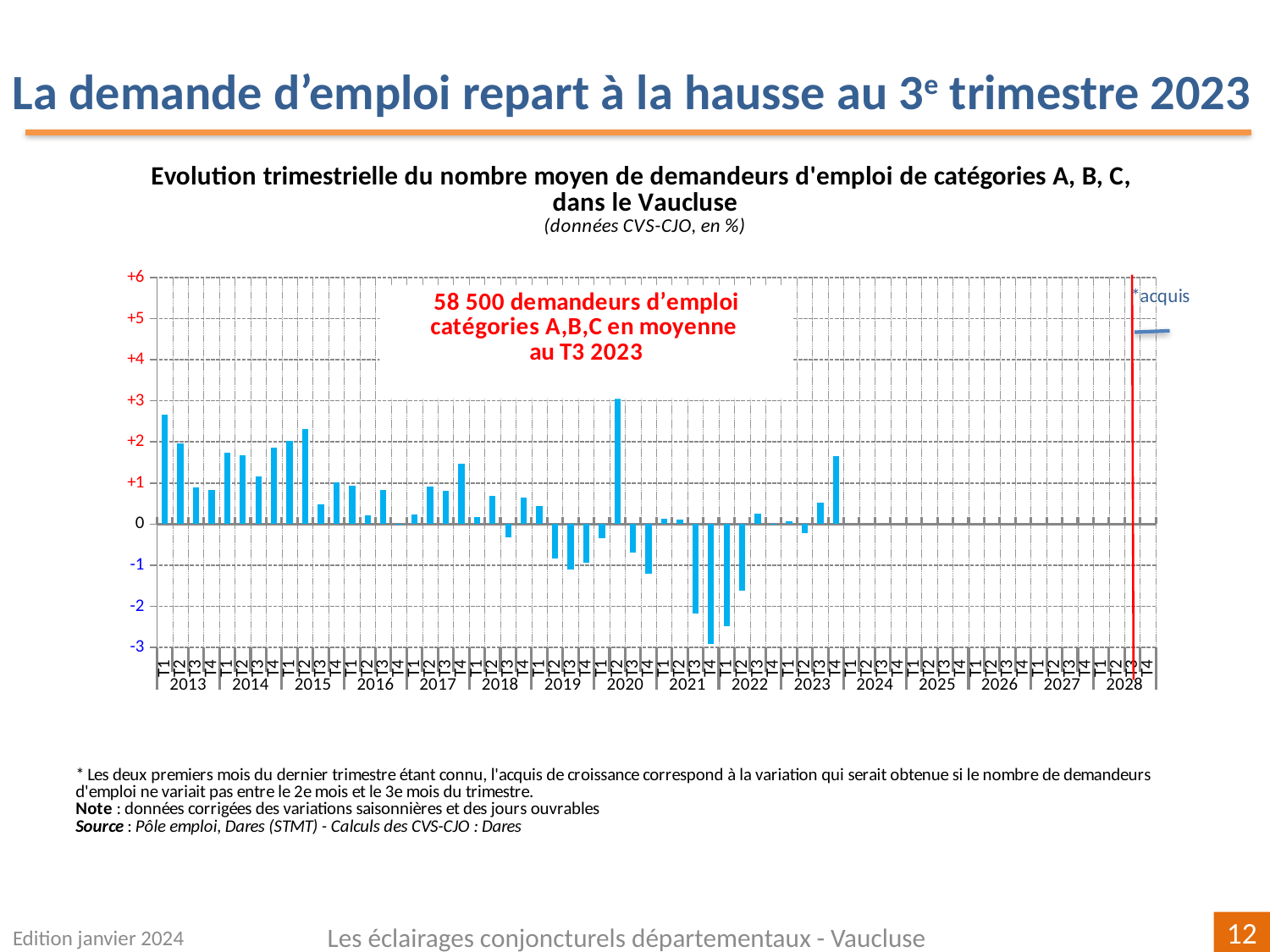
Is the value for T2 2020 greater or less than +2? greater Is the value for T2 2022 greater or less than -1? less Between T4 2021 and T3 2022, do the values rise or fall? rise Which quarter has the highest bar in the chart? T2 2020 Is the value for T4 2021 greater or less than -2? less Which is larger, the value for T1 2013 or the value for T3 2013? T1 2013 Which is larger, the value for T2 2020 or the value for T3 2020? T2 2020 Which quarter has the lowest bar in the chart? T4 2021 According to the annotation on the chart, how many demandeurs d'emploi of categories A, B, C were there on average in T3 2023? 58 500 What kind of chart is shown on the slide? bar chart How many years are labelled along the x axis of the chart? 16